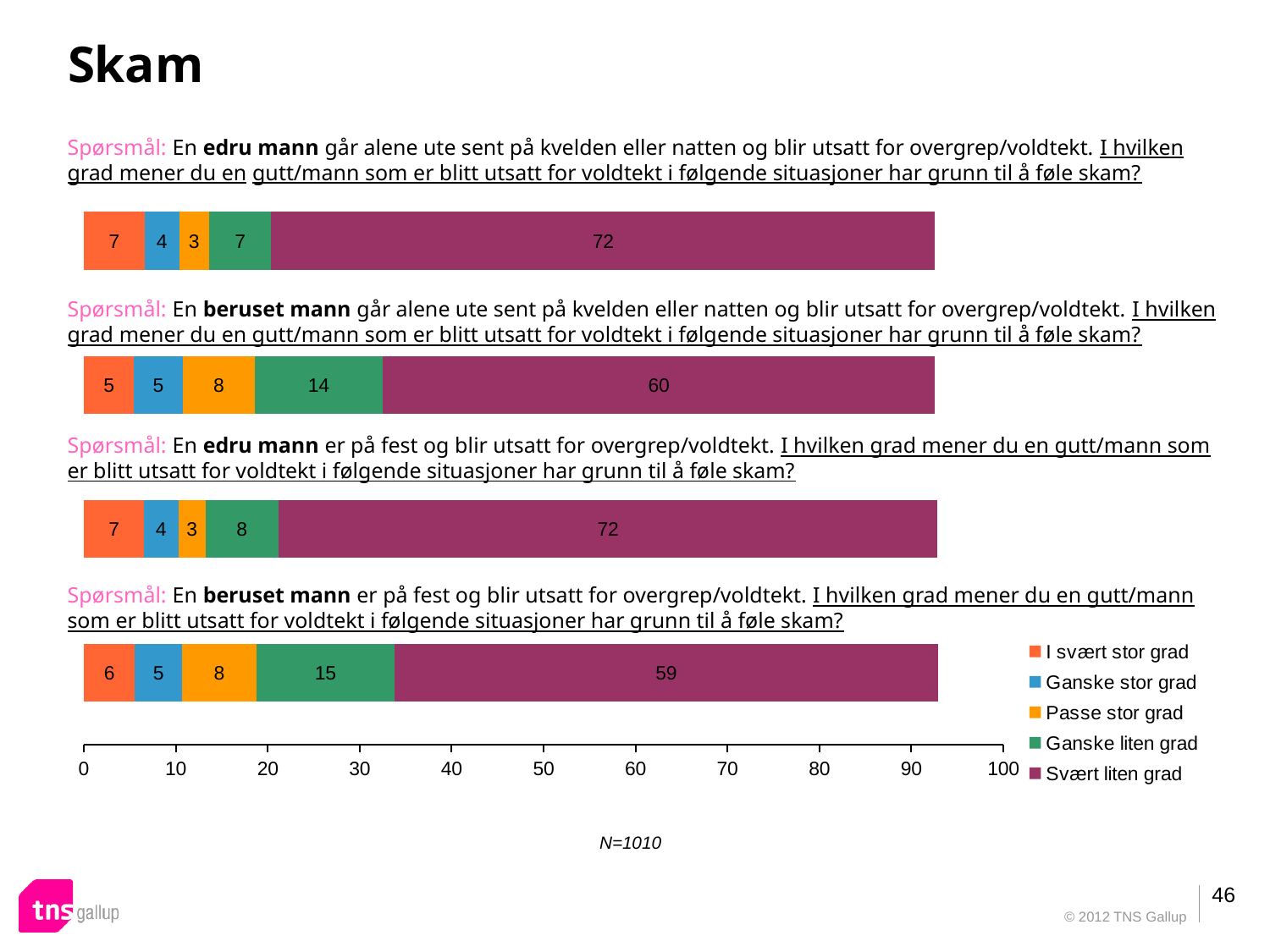
How many stacked bars are shown on the slide? 4 In the top bar (sober man out late at night), what is the value for 'Svært liten grad'? 72 How many series does the legend list? 5 Which is larger: 'Ganske liten grad' in the second bar (drunk man out late) or 'Ganske liten grad' in the top bar (sober man out late)? Second bar (drunk man out late), 14 Which colour represents 'Svært liten grad' in the legend? Purple In the second bar (drunk man out late at night), what is the value for 'Ganske liten grad'? 14 In the bottom bar (drunk man at a party), what is the value for 'Svært liten grad'? 59 In the second bar (drunk man out late at night), what is the difference between 'Svært liten grad' and 'Ganske liten grad'? 46 In the third bar (sober man at a party), what is the value for 'Passe stor grad'? 3 In the bottom bar (drunk man at a party), which category has the highest value? Svært liten grad What kind of chart is shown on the slide? Stacked bar chart What is the total of the segments in the bottom bar (drunk man at a party)? 93